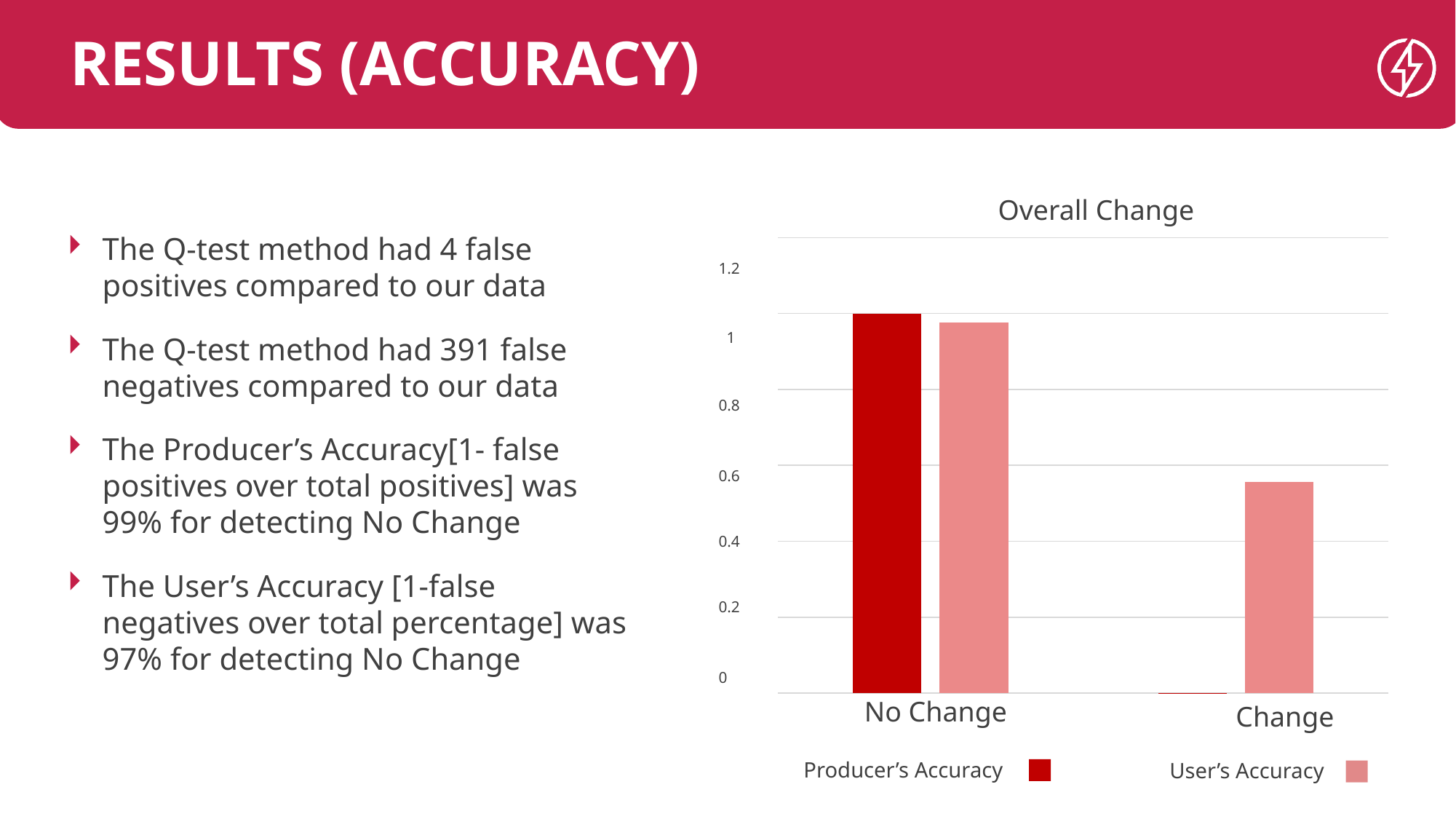
Is the User's Accuracy value for Change greater or less than 0.4? greater Which two series are listed in the chart's legend? Producer's Accuracy and User's Accuracy For the Change category, which series has the larger value, Producer's Accuracy or User's Accuracy? User's Accuracy Which bar in the chart has the lowest value? Producer's Accuracy for Change Is the Producer's Accuracy value for No Change greater or less than 0.8? greater What type of chart is shown on the slide? bar chart How many series does the chart's legend list? 2 Is the User's Accuracy value for Change greater or less than 0.8? less How many categories are shown on the x axis of the chart? 2 What is the title of the chart? Overall Change